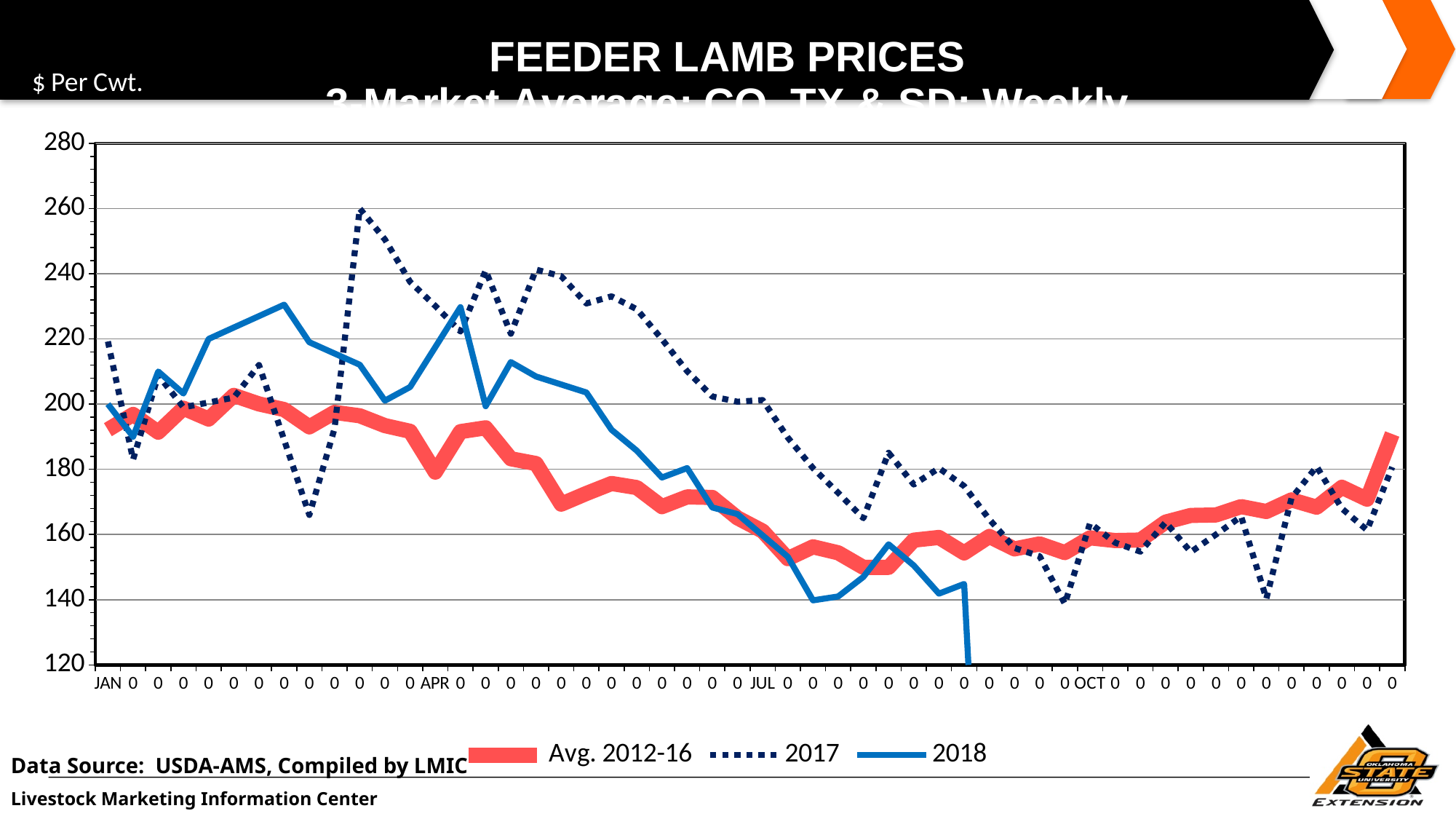
What kind of chart is shown on the slide? line chart What unit is shown for the vertical axis? $ Per Cwt. At JUL, which series is higher, 2017 or Avg. 2012-16? 2017 Is the peak value of the 2017 series greater or less than 240? greater How many series does the legend list? 3 Is the value for 2017 at JAN greater or less than 200? greater At APR, which series is higher, 2017 or 2018? 2017 Which series is drawn as a dotted line? 2017 Does the Avg. 2012-16 series rise or fall from JAN to JUL? fall Which series reaches the lowest value anywhere on the chart? 2018 Which series reaches the highest value anywhere on the chart? 2017 Is the value for Avg. 2012-16 at JAN greater or less than 180? greater